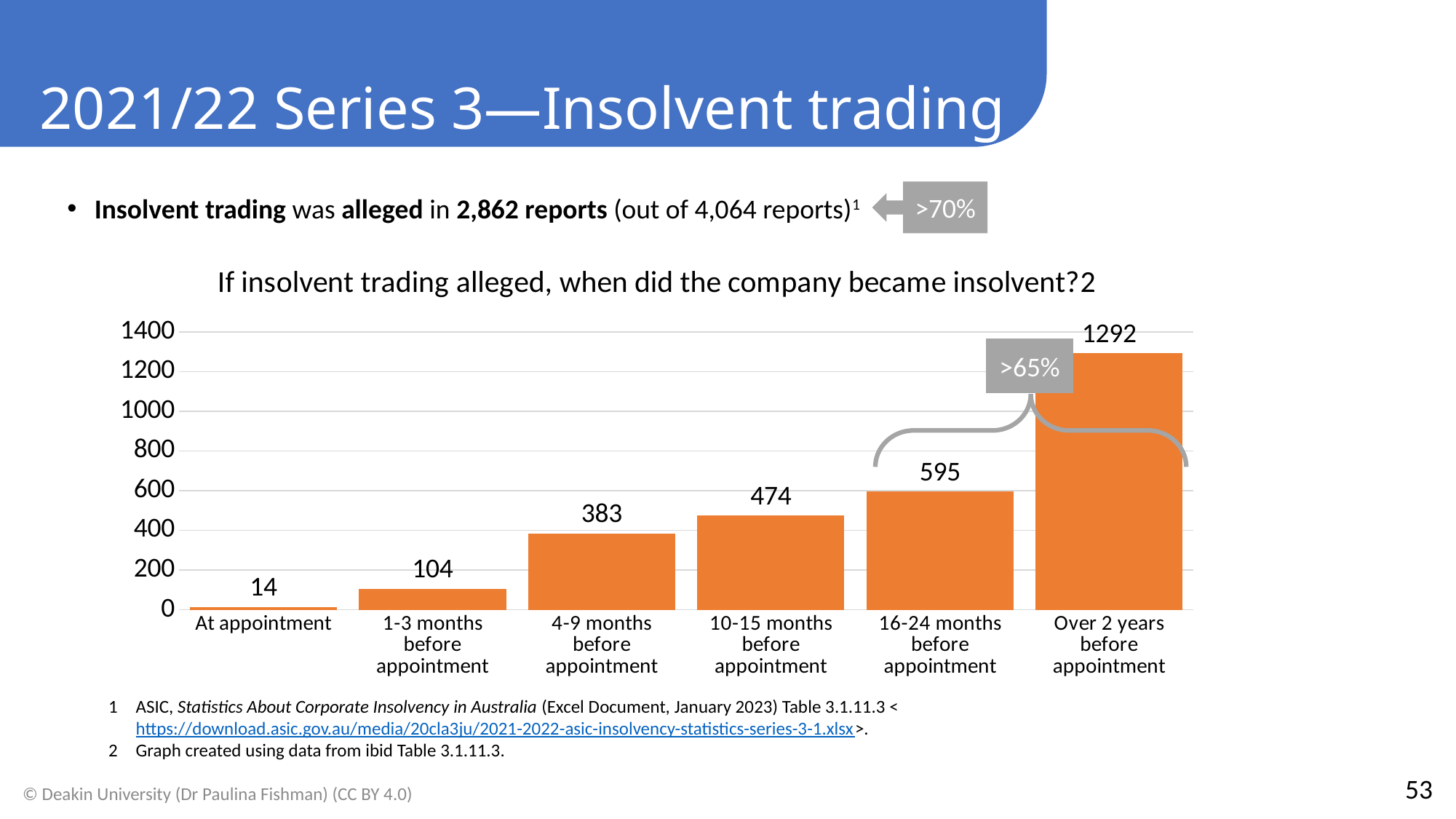
What kind of chart is shown on the slide? Bar chart Which category has the lowest value? At appointment Which is larger: the value for '1-3 months before appointment' or '4-9 months before appointment'? 4-9 months before appointment What is the value for 'At appointment'? 14 How many categories are shown on the x axis? 6 Do the values rise or fall moving from left to right along the x axis? Rise What is the difference between the values for '16-24 months before appointment' and '10-15 months before appointment'? 121 What is the title of the chart? If insolvent trading alleged, when did the company became insolvent? Which category has the highest value? Over 2 years before appointment What is the value for '4-9 months before appointment'? 383 Is the value for '16-24 months before appointment' greater or less than 400? greater What is the value for 'Over 2 years before appointment'? 1292